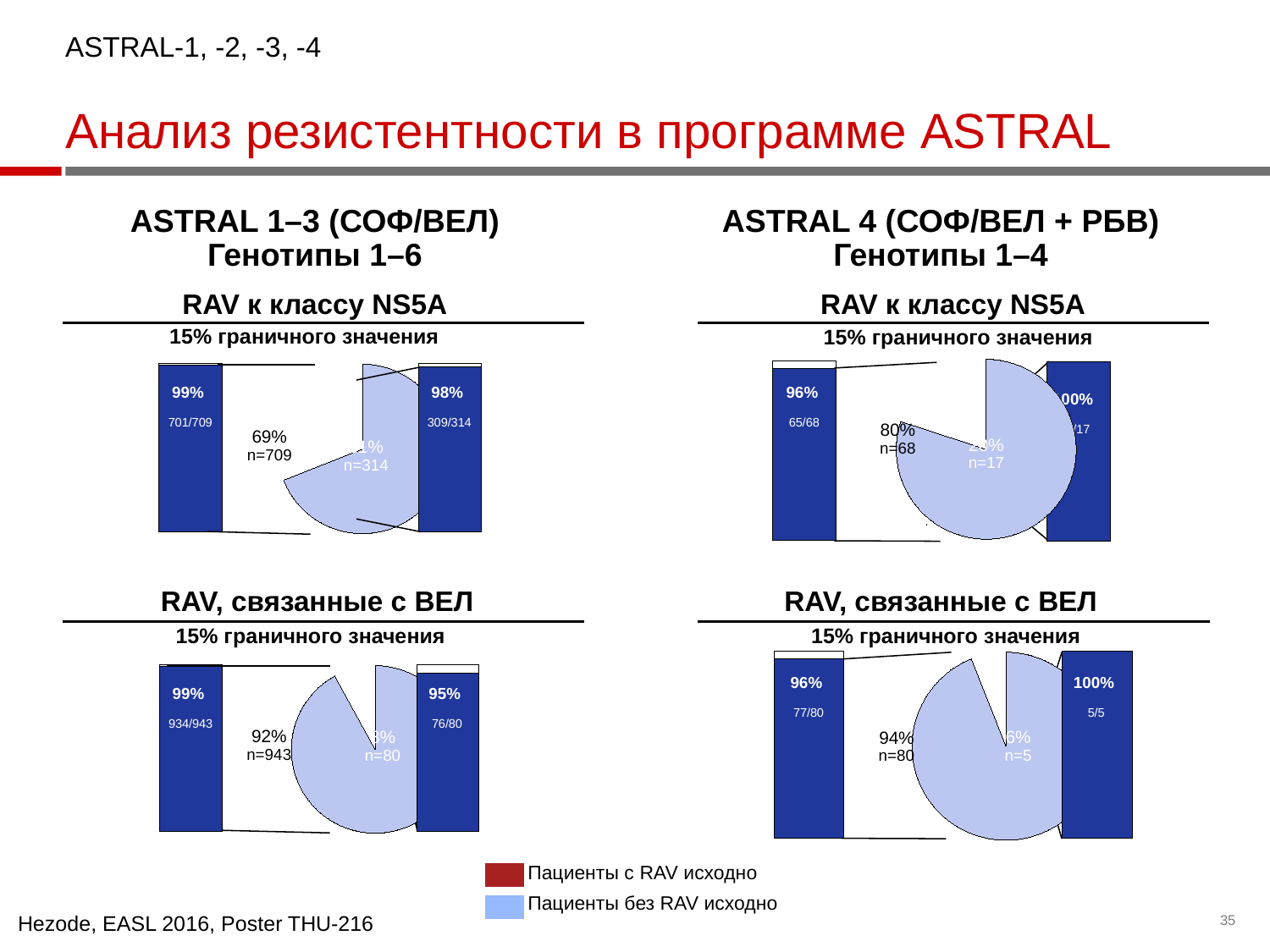
In the ASTRAL 1–3 'RAV, связанные с ВЕЛ' chart (bottom left), what fraction is printed under the 95% bar? 76/80 In the ASTRAL 1–3 'RAV к классу NS5A' chart (top left), what share of the pie is labelled with n=709? 69% In the ASTRAL 4 'RAV, связанные с ВЕЛ' chart (bottom right), what percentage is shown for the right bar labelled 5/5? 100% In the ASTRAL 1–3 'RAV к классу NS5A' chart (top left), what fraction is printed under the 99% bar? 701/709 How many entries does the legend at the bottom of the slide list? 2 In the ASTRAL 1–3 'RAV, связанные с ВЕЛ' chart (bottom left), what is the difference between the two bar percentages, 99% and 95%? 4% In the ASTRAL 1–3 'RAV к классу NS5A' chart (top left), what percentage is shown for the left bar? 99% In the ASTRAL 1–3 'RAV, связанные с ВЕЛ' chart (bottom left), what share of the pie is labelled with n=943? 92% In the ASTRAL 4 'RAV к классу NS5A' chart (top right), what share of the pie is labelled with n=68? 80% In the ASTRAL 4 'RAV к классу NS5A' chart (top right), what fraction is printed under the 96% bar? 65/68 In the ASTRAL 1–3 'RAV к классу NS5A' chart (top left), what percentage is shown for the right bar? 98% In the ASTRAL 4 'RAV, связанные с ВЕЛ' chart (bottom right), which bar is higher: the one labelled 77/80 or the one labelled 5/5? 5/5